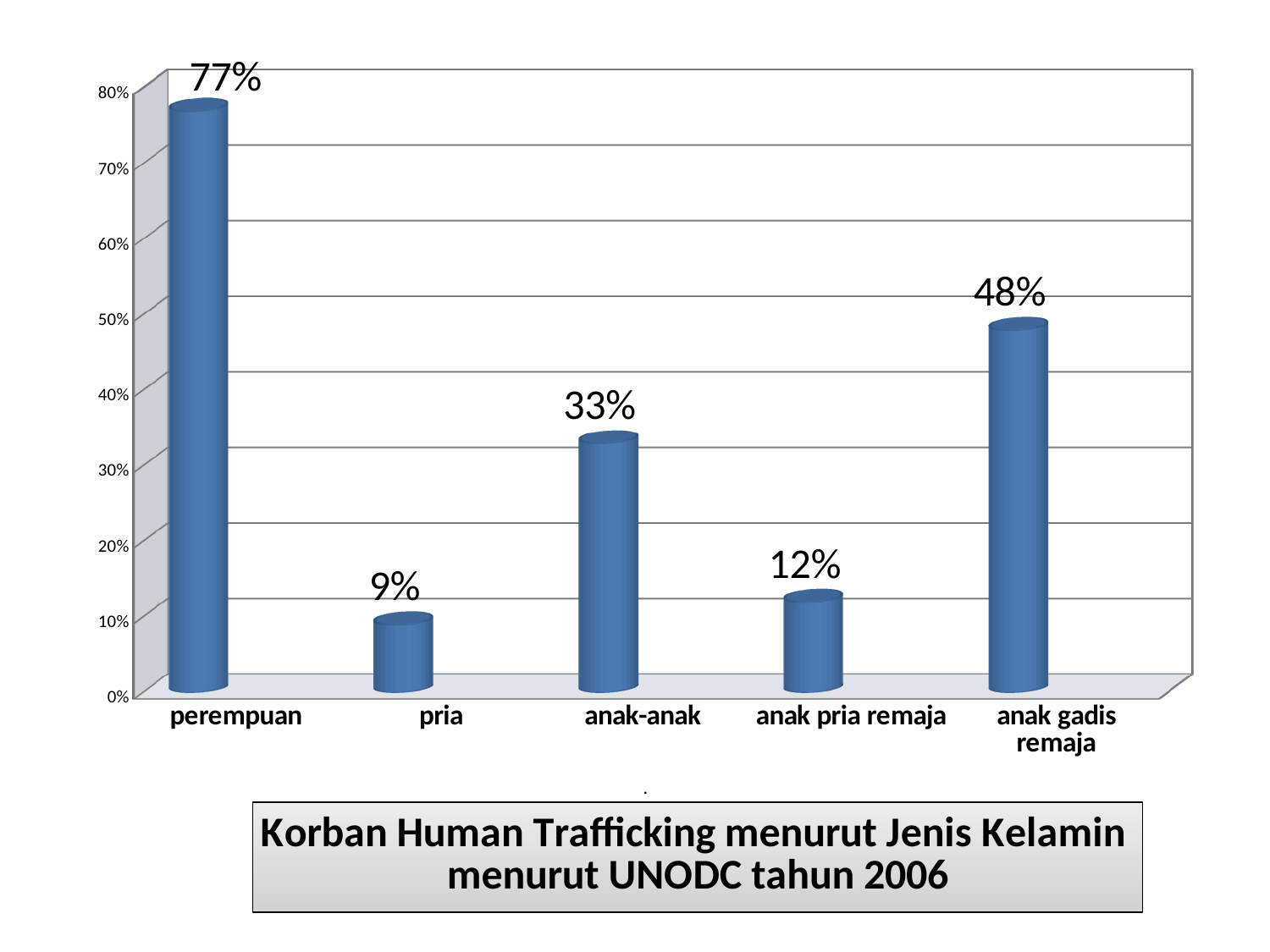
Which category has the highest value? perempuan What kind of chart is shown on the slide? bar chart How many categories are shown on the x axis? 5 What is the difference between the values for anak-anak and anak pria remaja? 21% Which category has the lowest value? pria What is the title shown below the chart? Korban Human Trafficking menurut Jenis Kelamin menurut UNODC tahun 2006 What is the value for perempuan? 77% Which is larger, the value for anak-anak or the value for anak pria remaja? anak-anak What is the value for pria? 9% Is the value for anak gadis remaja greater or less than 40%? greater What is the difference between the values for perempuan and anak gadis remaja? 29% What is the value for anak gadis remaja? 48%